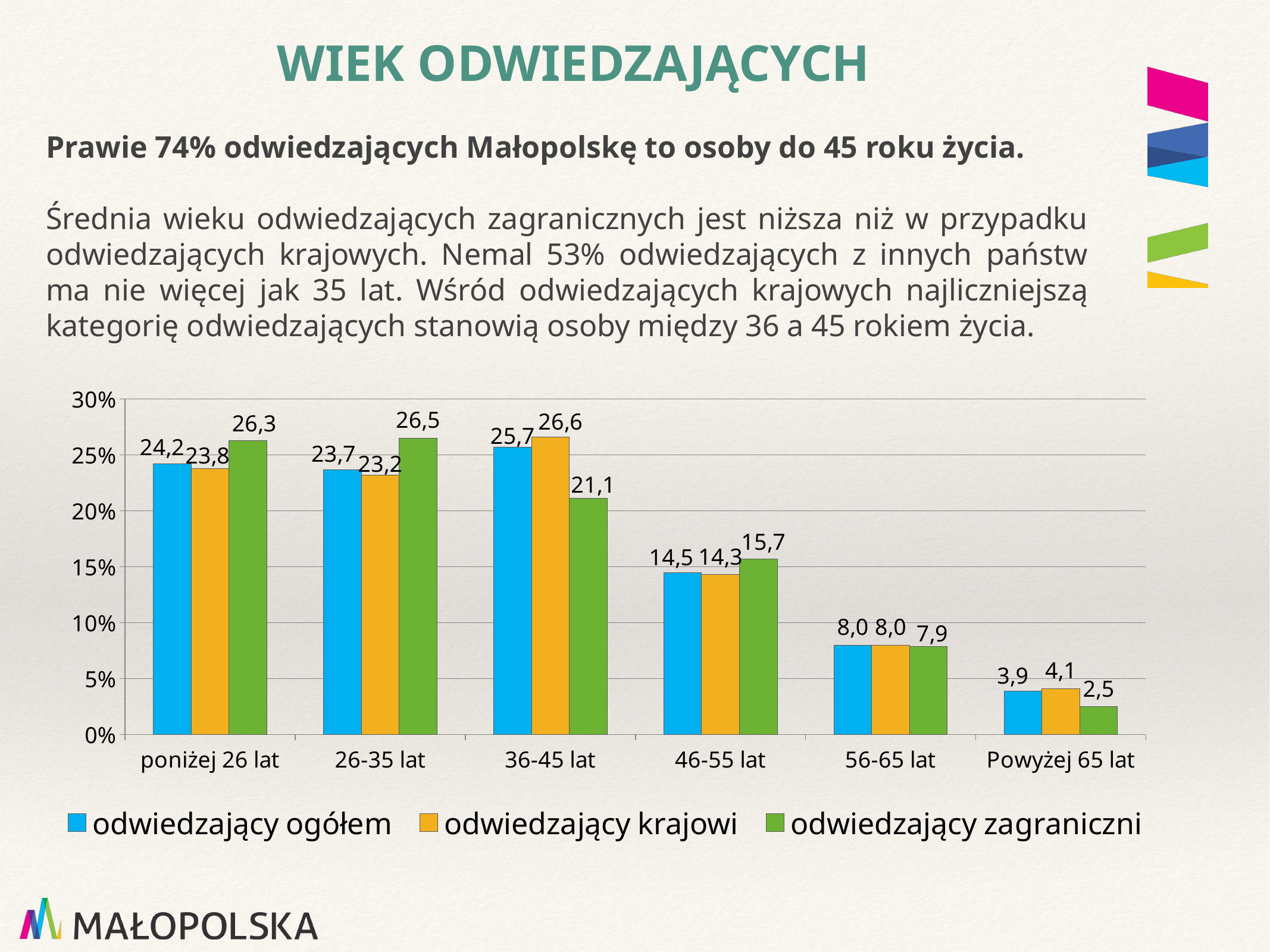
What is the value for 'odwiedzający krajowi' in the 'Powyżej 65 lat' category? 4,1 What is the value for 'odwiedzający zagraniczni' in the '36-45 lat' category? 21,1 Which age category has the lowest value for 'odwiedzający zagraniczni'? Powyżej 65 lat In the '26-35 lat' category, which is larger: 'odwiedzający ogółem' or 'odwiedzający zagraniczni'? odwiedzający zagraniczni How many series does the legend list? 3 What is the value for 'odwiedzający ogółem' in the 'poniżej 26 lat' category? 24,2 Is the value for 'odwiedzający ogółem' in the '46-55 lat' category greater or less than 15%? less What is the difference between 'odwiedzający krajowi' and 'odwiedzający zagraniczni' in the '36-45 lat' category? 5,5 What kind of chart is shown on the slide? bar chart How many age categories are shown on the x axis? 6 Which colour represents 'odwiedzający krajowi' in the legend? orange Which age category has the highest value for 'odwiedzający krajowi'? 36-45 lat